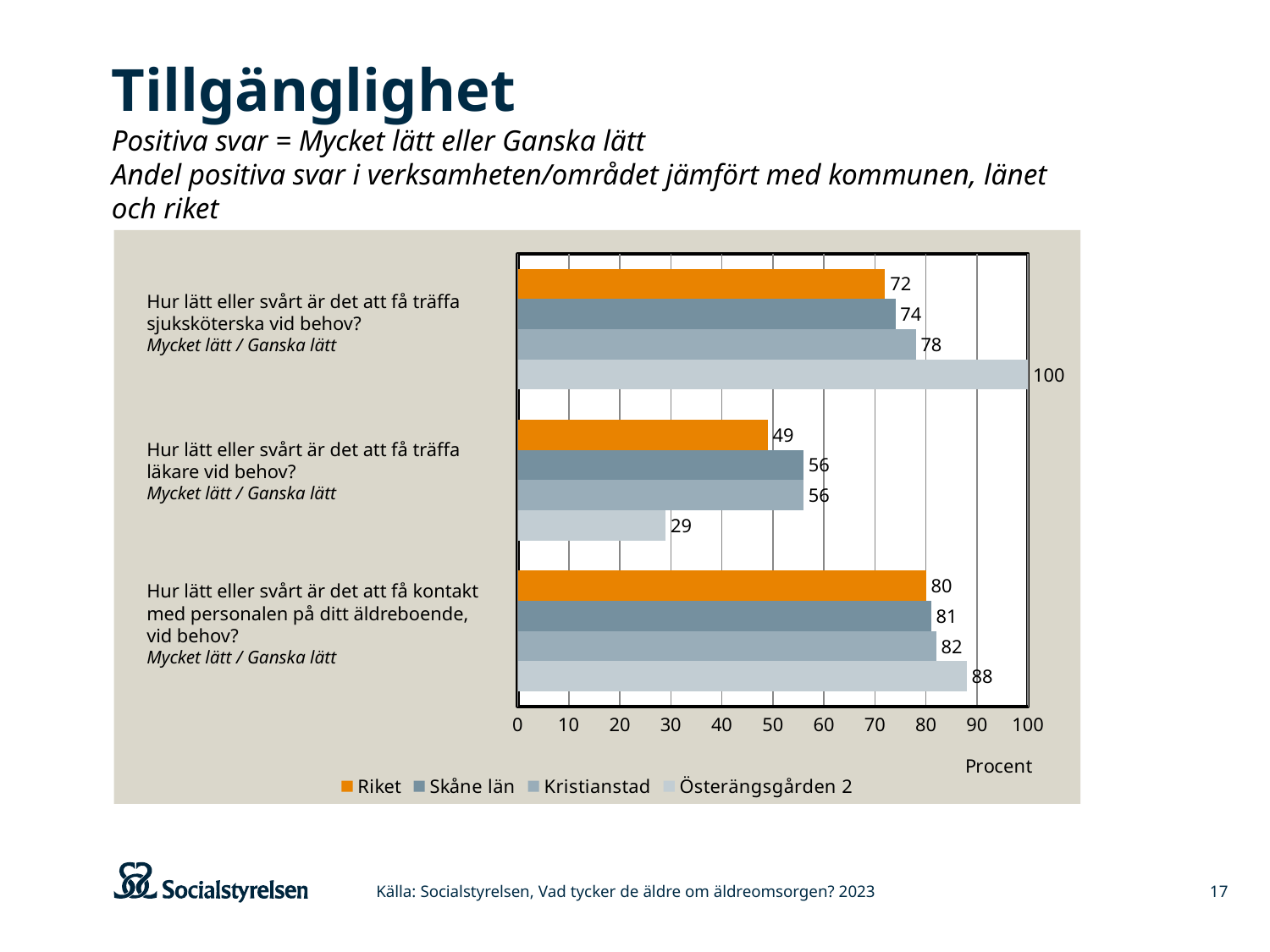
What is the difference between Österängsgården 2 and Riket for "Hur lätt eller svårt är det att få träffa sjuksköterska vid behov?"? 28 What unit label is shown on the x axis of the chart? Procent What is the difference between Skåne län and Österängsgården 2 for "Hur lätt eller svårt är det att få träffa läkare vid behov?"? 27 Which series has the highest value for "Hur lätt eller svårt är det att få kontakt med personalen på ditt äldreboende, vid behov?"? Österängsgården 2 What kind of chart is shown on the slide? bar chart For "Hur lätt eller svårt är det att få träffa läkare vid behov?", which is larger: the value for Skåne län or the value for Österängsgården 2? Skåne län What is the value for Österängsgården 2 for "Hur lätt eller svårt är det att få träffa sjuksköterska vid behov?"? 100 Which series has the lowest value for "Hur lätt eller svårt är det att få träffa läkare vid behov?"? Österängsgården 2 What is the value for Kristianstad for "Hur lätt eller svårt är det att få kontakt med personalen på ditt äldreboende, vid behov?"? 82 What is the value for Riket for "Hur lätt eller svårt är det att få träffa läkare vid behov?"? 49 How many series does the legend list? 4 How many question categories are plotted on the chart? 3